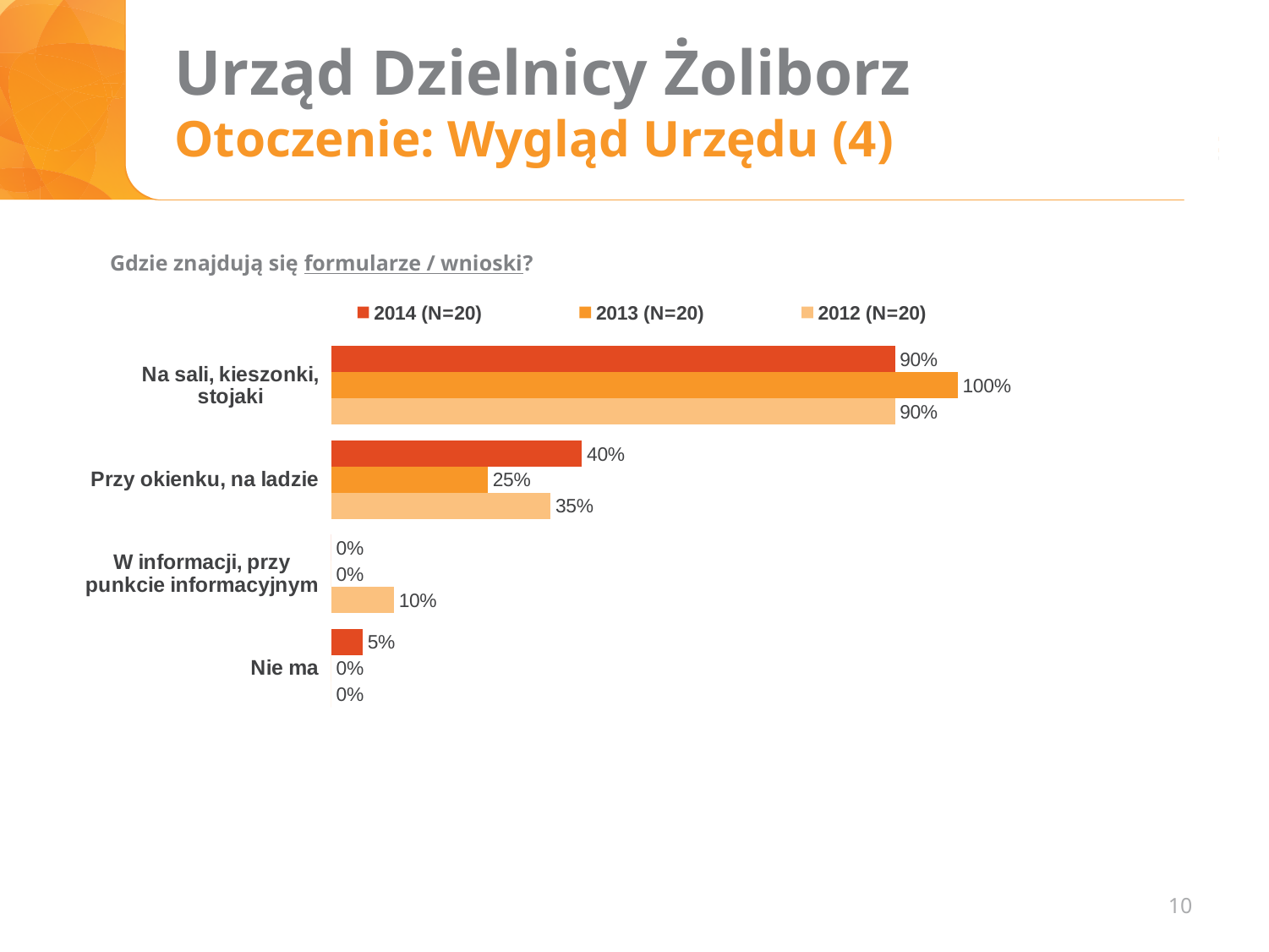
What is the value for "Nie ma" in the 2014 (N=20) series? 5% What is the difference between the 2014 (N=20) and 2013 (N=20) values for "Przy okienku, na ladzie"? 15% What question does the chart answer, as stated above it? Gdzie znajdują się formularze / wnioski? Which category has the highest value in the 2014 (N=20) series? Na sali, kieszonki, stojaki What is the value for "W informacji, przy punkcie informacyjnym" in the 2012 (N=20) series? 10% How many categories are shown on the chart? 4 What kind of chart is shown on the slide? Bar chart For "Przy okienku, na ladzie", which is larger: the 2012 (N=20) value or the 2013 (N=20) value? 2012 (N=20) What is the value for "Na sali, kieszonki, stojaki" in the 2013 (N=20) series? 100% What is the value for "Przy okienku, na ladzie" in the 2014 (N=20) series? 40% Which category has the lowest value in the 2013 (N=20) series? W informacji, przy punkcie informacyjnym and Nie ma (both 0%) How many series does the legend list? 3